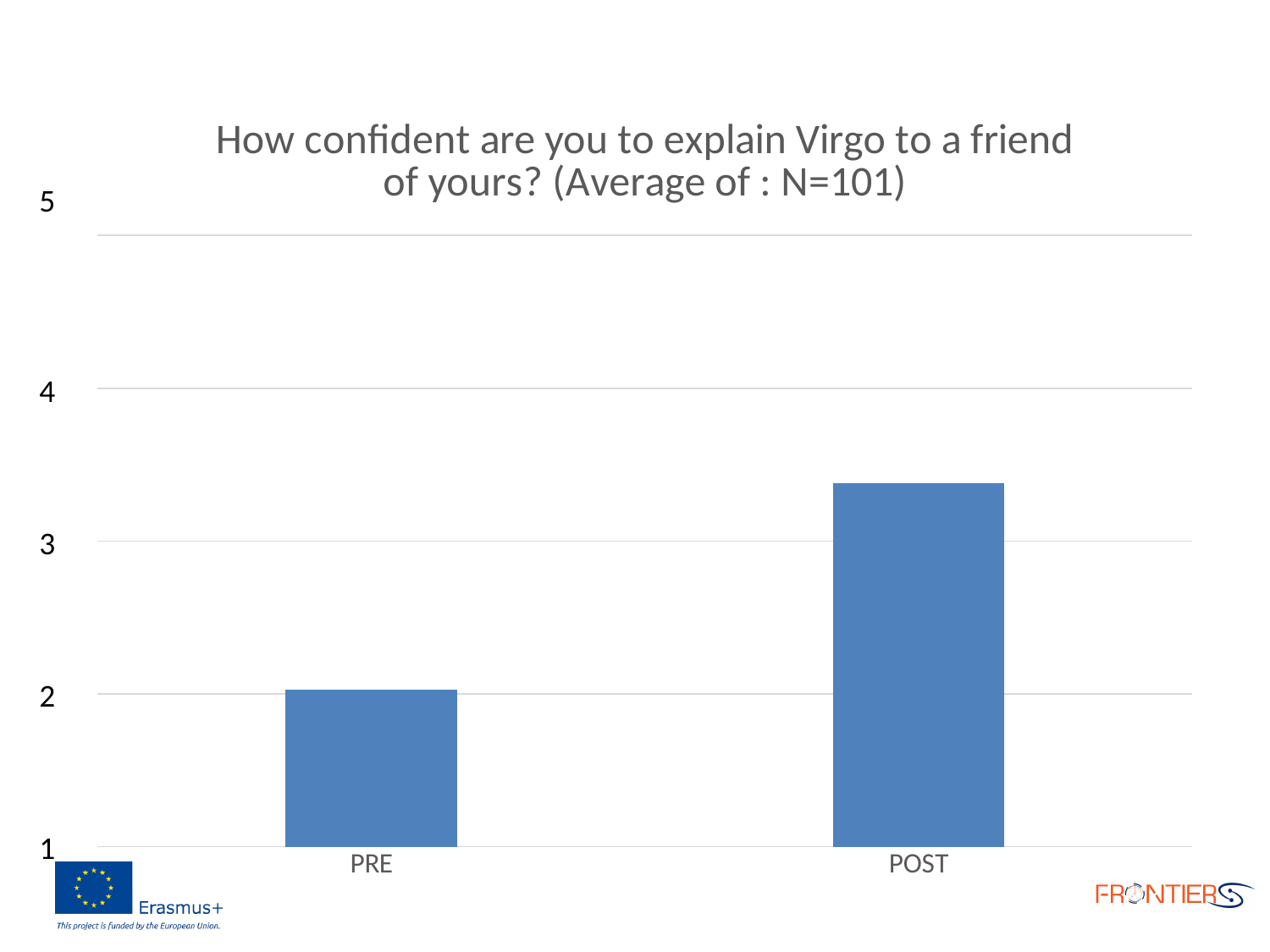
What is the highest value shown on the chart's vertical axis? 5 Is the value for PRE greater or less than 3? less Which is larger, the value for PRE or the value for POST? POST What is the title of the chart? How confident are you to explain Virgo to a friend of yours? (Average of : N=101) What kind of chart is shown on the slide? bar chart Which category has the lowest value in the chart? PRE Is the value for POST greater or less than 4? less Which category has the highest value in the chart? POST Is the value for POST greater or less than 3? greater Do the values rise or fall from PRE to POST? rise How many categories are shown on the x axis of the chart? 2